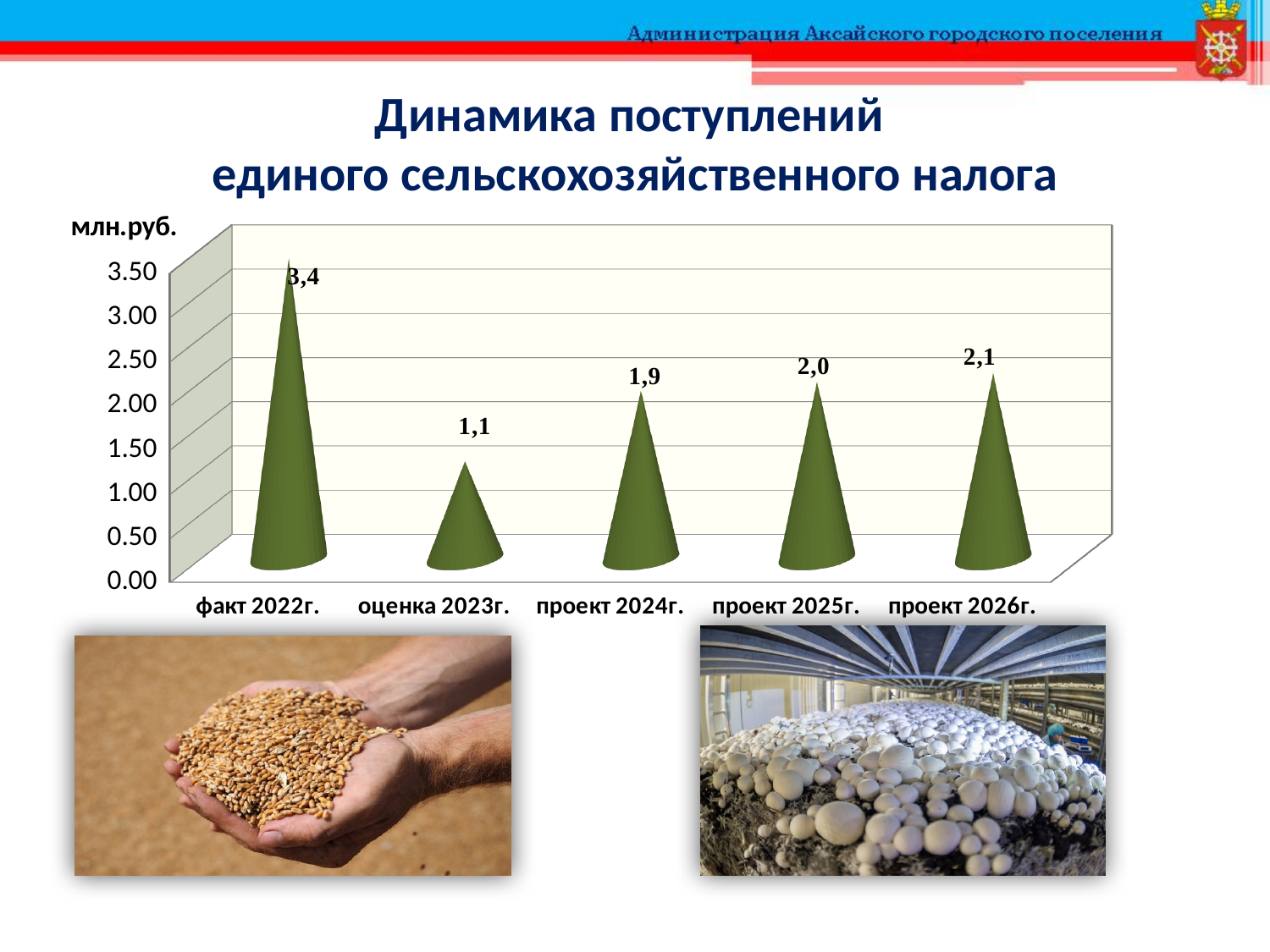
What unit is indicated for the values on the chart? млн.руб. Which category has the highest value? факт 2022г. What is the value for проект 2024г.? 1,9 What is the difference between the values for факт 2022г. and оценка 2023г.? 2,3 Is the value for проект 2024г. greater or less than 1.50? greater What is the value for проект 2026г.? 2,1 What is the value for оценка 2023г.? 1,1 What kind of chart is shown on the slide? bar chart What is the value for факт 2022г.? 3,4 Which category has the lowest value? оценка 2023г. Which is larger, the value for проект 2025г. or the value for оценка 2023г.? проект 2025г. How many categories are shown on the x axis? 5